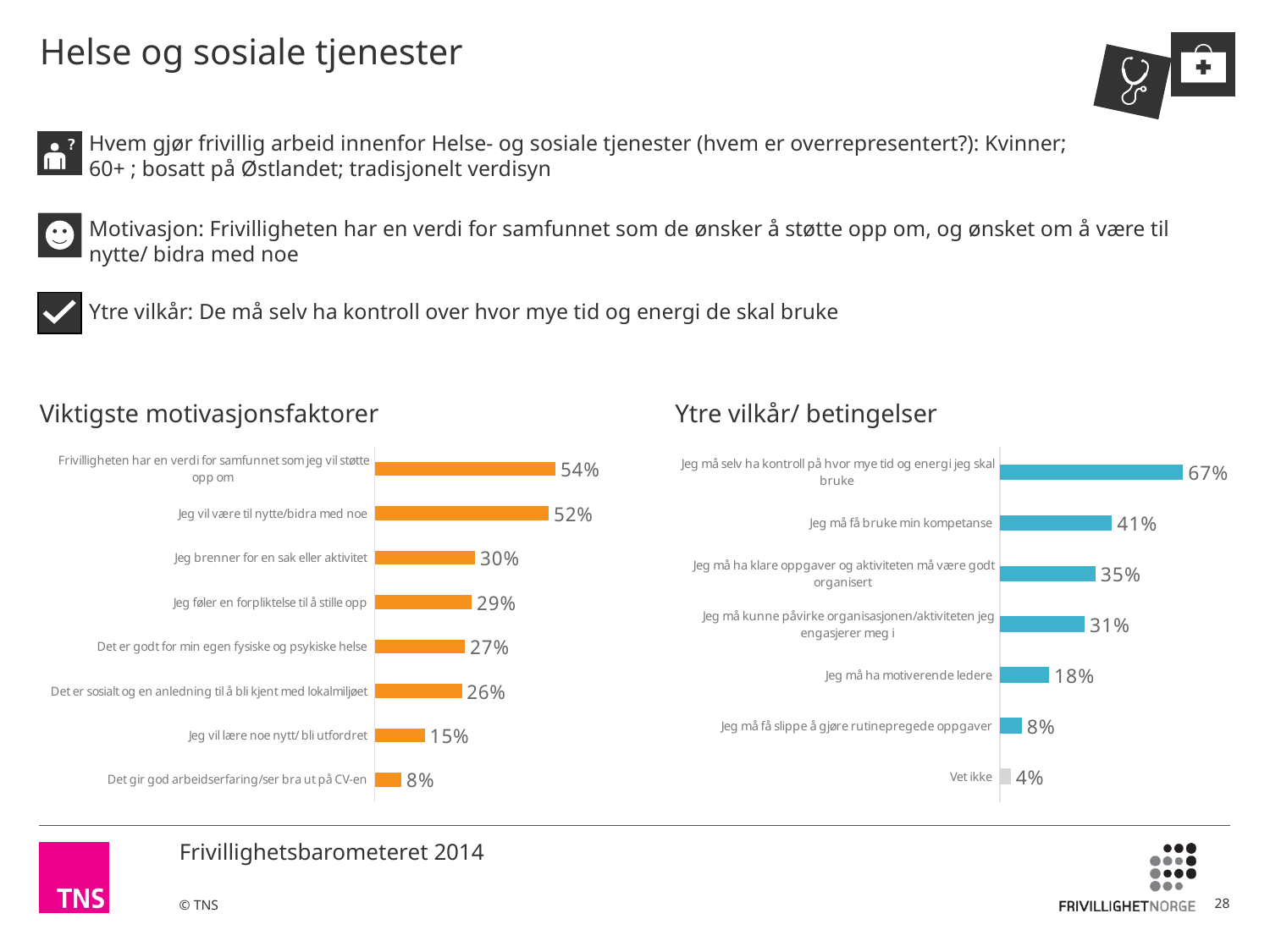
In the 'Viktigste motivasjonsfaktorer' chart, how many categories are shown? 8 In the 'Ytre vilkår/ betingelser' chart, what is the value for 'Vet ikke'? 4% In the 'Viktigste motivasjonsfaktorer' chart, what is the value for 'Jeg vil være til nytte/bidra med noe'? 52% In the 'Viktigste motivasjonsfaktorer' chart, what is the difference between 'Jeg brenner for en sak eller aktivitet' and 'Jeg vil lære noe nytt/ bli utfordret'? 15% In the 'Viktigste motivasjonsfaktorer' chart, which category has the highest value? Frivilligheten har en verdi for samfunnet som jeg vil støtte opp om What type of chart is the 'Viktigste motivasjonsfaktorer' chart? Bar chart In the 'Ytre vilkår/ betingelser' chart, what is the value for 'Jeg må få bruke min kompetanse'? 41% In the 'Ytre vilkår/ betingelser' chart, how many categories are shown? 7 In the 'Viktigste motivasjonsfaktorer' chart, which category has the lowest value? Det gir god arbeidserfaring/ser bra ut på CV-en In the 'Ytre vilkår/ betingelser' chart, which is larger: 'Jeg må ha klare oppgaver og aktiviteten må være godt organisert' or 'Jeg må kunne påvirke organisasjonen/aktiviteten jeg engasjerer meg i'? Jeg må ha klare oppgaver og aktiviteten må være godt organisert In the 'Ytre vilkår/ betingelser' chart, what is the difference between 'Jeg må selv ha kontroll på hvor mye tid og energi jeg skal bruke' and 'Jeg må ha motiverende ledere'? 49% In the 'Ytre vilkår/ betingelser' chart, which category has the highest value? Jeg må selv ha kontroll på hvor mye tid og energi jeg skal bruke